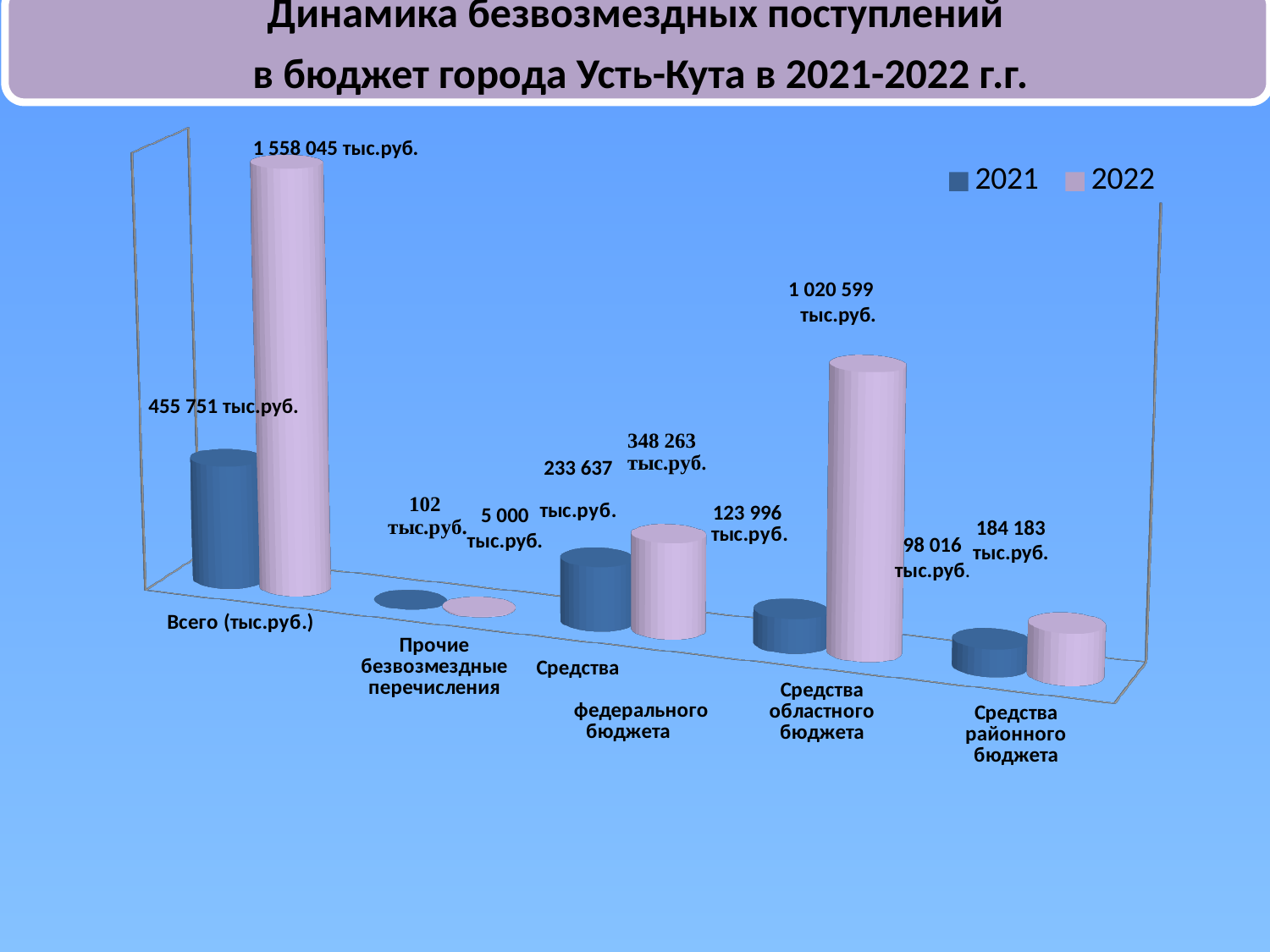
What is the 2022 value for Всего (тыс.руб.)? 1 558 045 тыс.руб. Which is larger: the 2021 value for Средства федерального бюджета or the 2021 value for Средства областного бюджета? Средства федерального бюджета Which category has the lowest 2021 value? Прочие безвозмездные перечисления What is the 2022 value for Прочие безвозмездные перечисления? 5 000 тыс.руб. What is the 2021 value for Средства районного бюджета? 98 016 тыс.руб. Excluding the Всего total, which category has the highest 2022 value? Средства областного бюджета How many categories are shown on the x axis? 5 How many series does the legend list? 2 What kind of chart is shown on the slide? Bar chart What is the 2021 value for Средства областного бюджета? 123 996 тыс.руб. What is the difference between the 2022 and 2021 values for Средства федерального бюджета? 114 626 тыс.руб. What is the difference between the 2022 and 2021 values for Средства районного бюджета? 86 167 тыс.руб.